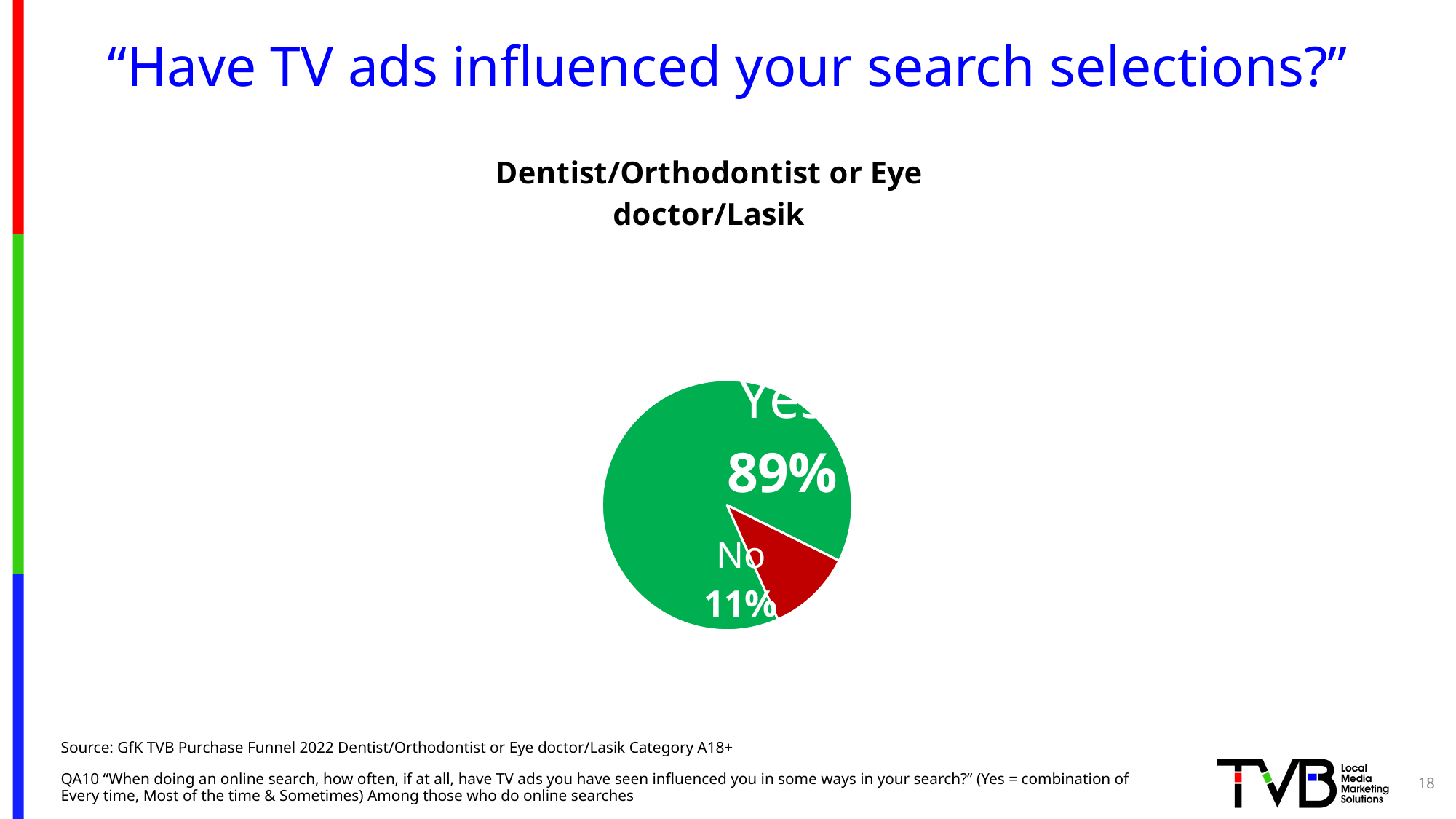
How many slices does the pie chart have? 2 What is the difference in percentage points between the "Yes" and "No" slices? 78 Which response has the largest share of the pie chart? Yes What share of the pie does the "No" slice represent? 11% What colour is the "No" slice of the pie chart? Red Which response has the smallest share of the pie chart? No What percentage of respondents answered "No" in the pie chart? 11% What is the title of the pie chart? Dentist/Orthodontist or Eye doctor/Lasik Which slice is larger, "Yes" or "No"? Yes What type of chart is shown on the slide? Pie chart What percentage of respondents answered "Yes" in the pie chart? 89%